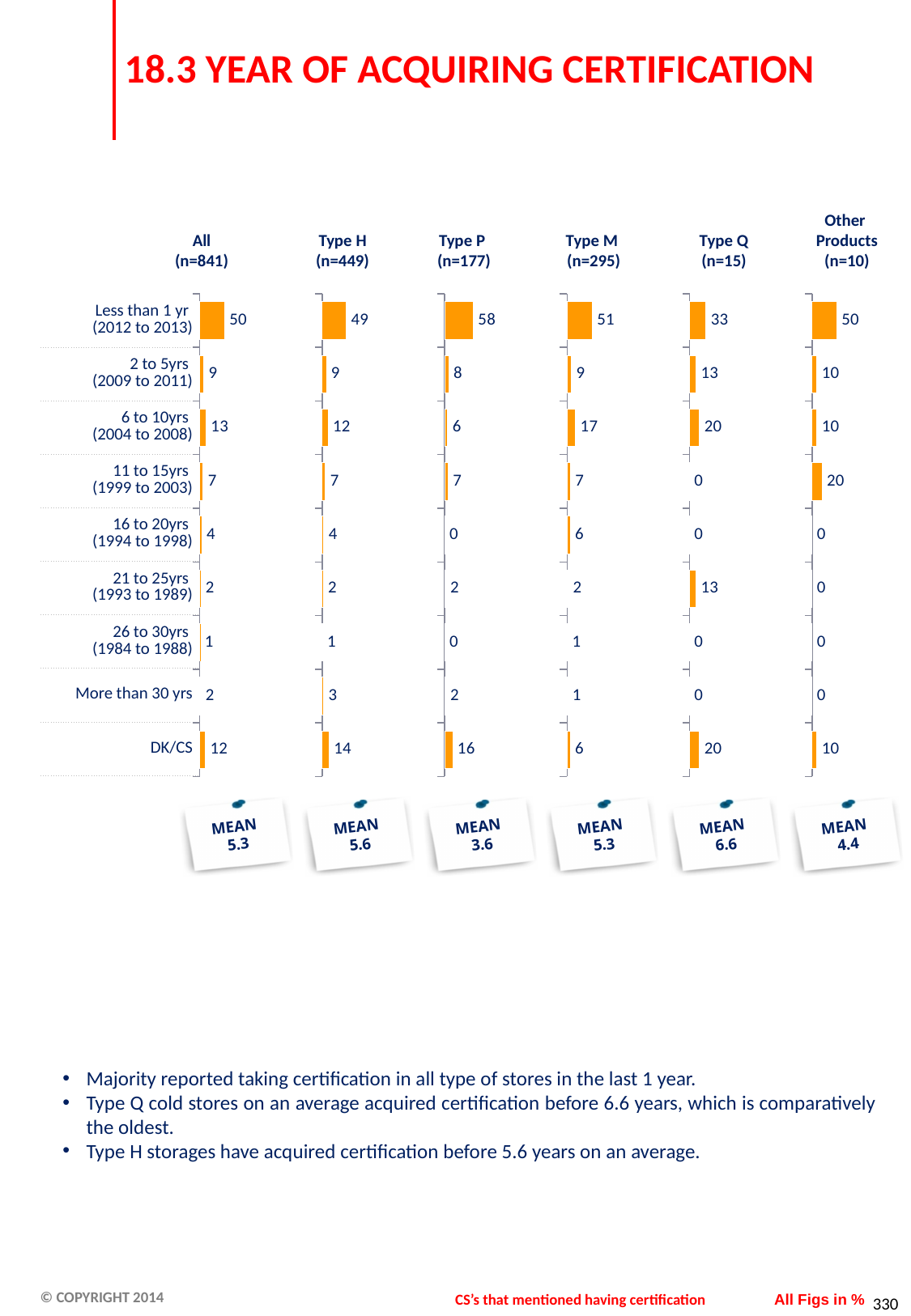
In the Type P (n=177) chart, what is the value for DK/CS? 16 In the Type Q (n=15) chart, what is the value for 21 to 25yrs (1993 to 1989)? 13 In the Type H (n=449) chart, what is the difference between the values for Less than 1 yr (2012 to 2013) and DK/CS? 35 In the All (n=841) chart, what is the value for Less than 1 yr (2012 to 2013)? 50 How many categories are shown in the All (n=841) chart? 9 What kind of chart is used for the Type P (n=177) data? Bar chart How many separate bar charts are shown on the slide? 6 In the Type M (n=295) chart, which category has the highest value? Less than 1 yr (2012 to 2013) In the Other Products (n=10) chart, which category has the highest value? Less than 1 yr (2012 to 2013) In the Type M (n=295) chart, which is larger: the value for 6 to 10yrs (2004 to 2008) or the value for 2 to 5yrs (2009 to 2011)? 6 to 10yrs (2004 to 2008) What is the MEAN shown below the Type Q (n=15) chart? 6.6 In the Type Q (n=15) chart, what is the difference between the values for 6 to 10yrs (2004 to 2008) and 2 to 5yrs (2009 to 2011)? 7